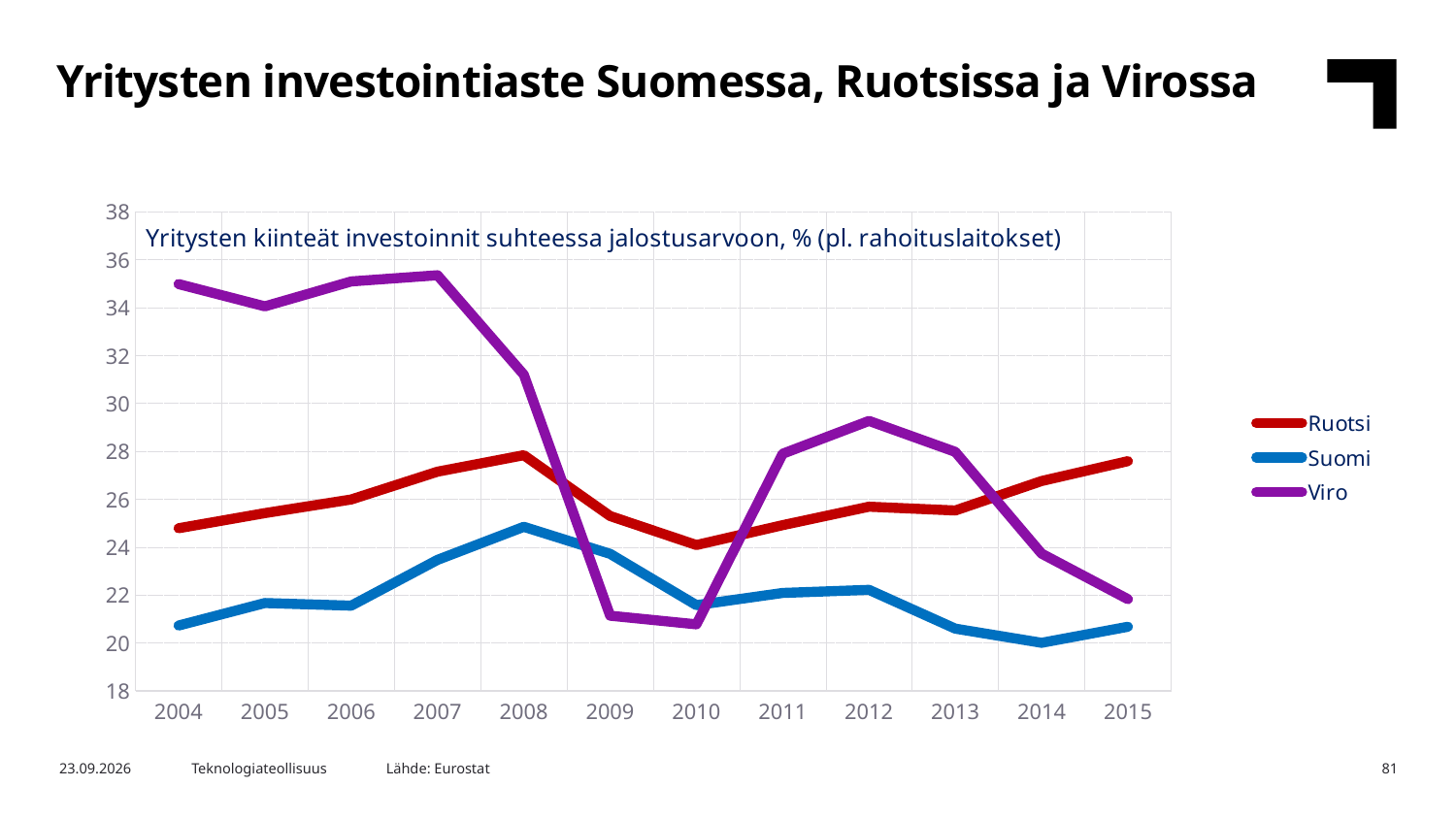
Is the value for Viro in 2010 greater or less than 22? less Is the value for Ruotsi in 2008 greater or less than 26? greater Which series has the highest value in 2012? Viro How many series does the legend list? 3 Which series has the highest value in 2004? Viro In which year does Suomi reach its highest value? 2008 What kind of chart is shown on the slide? line chart Is the value for Suomi in 2014 greater or less than 22? less In 2010, which is larger, the value for Ruotsi or the value for Viro? Ruotsi Does the value for Viro rise or fall from 2008 to 2009? fall How many years are shown on the x axis? 12